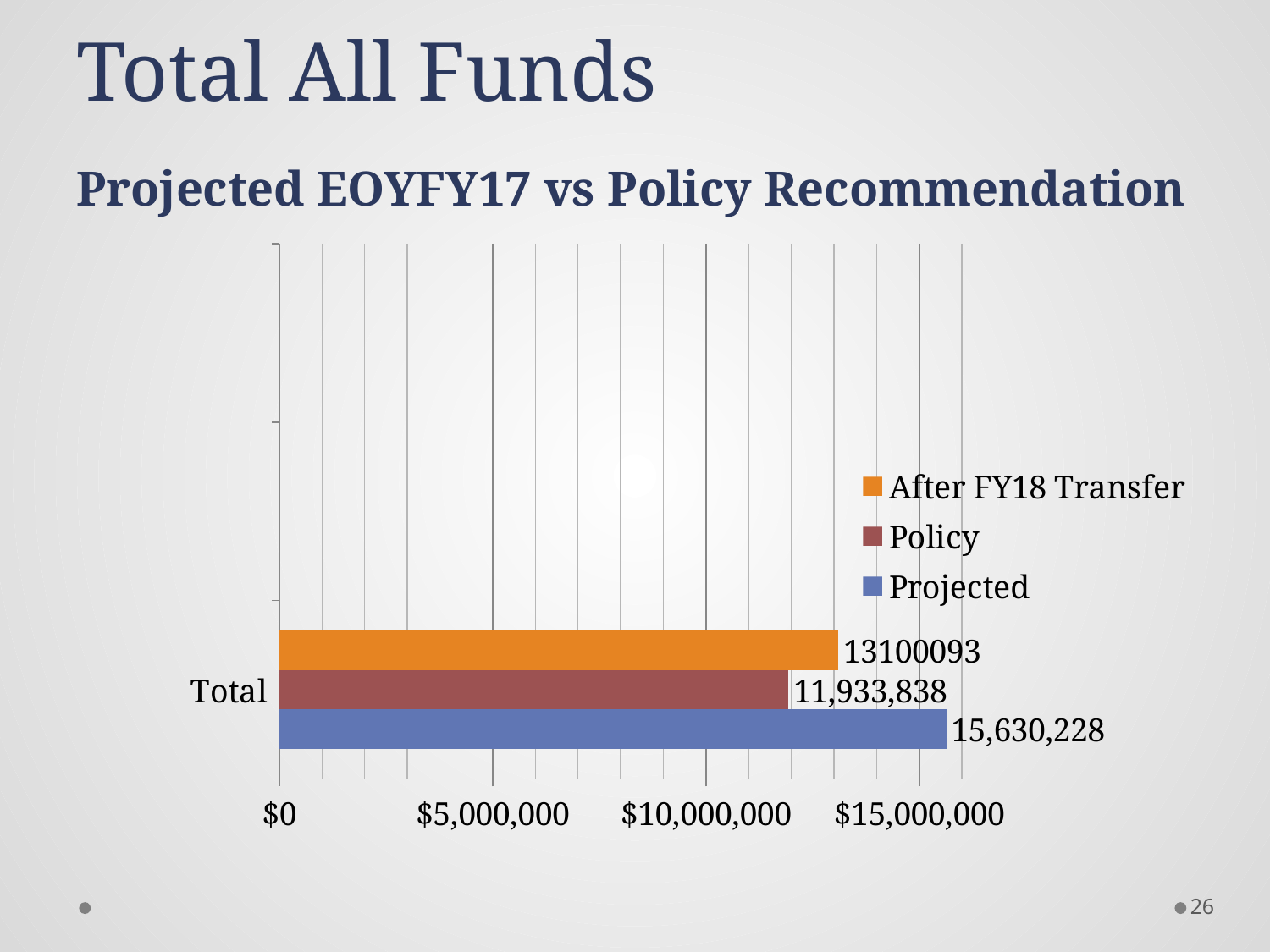
Is the Policy value greater or less than $10,000,000? greater What colour is the Projected series in the chart? Blue What is the value of the After FY18 Transfer bar for Total? 13100093 What is the value of the Projected bar for Total? 15,630,228 What is the value of the Policy bar for Total? 11,933,838 What kind of chart is shown on the slide? Bar chart Which is larger, the Policy value or the After FY18 Transfer value? After FY18 Transfer What is the difference between the Projected and After FY18 Transfer values? 2,530,135 Which series has the lowest value for Total? Policy How many series does the legend list? 3 Which series has the highest value for Total? Projected What is the difference between the Projected and Policy values? 3,696,390